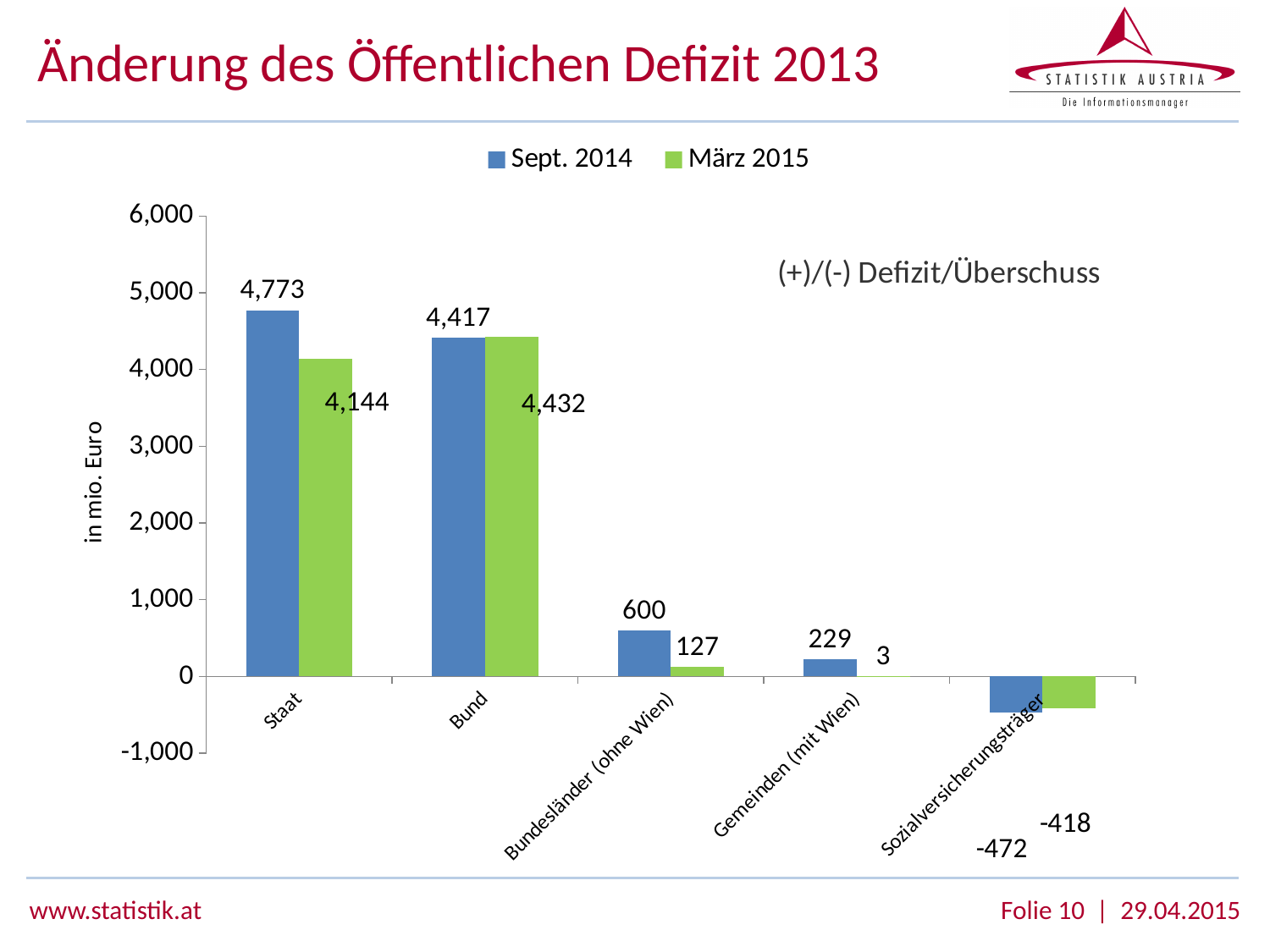
Which is larger for Bund: the Sept. 2014 value or the März 2015 value? März 2015 What unit is given on the y axis label? in mio. Euro How many series does the legend list? 2 How many categories are shown on the x axis? 5 Which category has the highest value in the Sept. 2014 series? Staat Which category has the lowest value in the März 2015 series? Sozialversicherungsträger What is the value for Staat in the Sept. 2014 series? 4,773 What is the value for Gemeinden (mit Wien) in the März 2015 series? 3 What is the value for Sozialversicherungsträger in the Sept. 2014 series? -472 What is the value for Bund in the März 2015 series? 4,432 What kind of chart is shown on the slide? bar chart What is the difference between the Sept. 2014 and März 2015 values for Bundesländer (ohne Wien)? 473